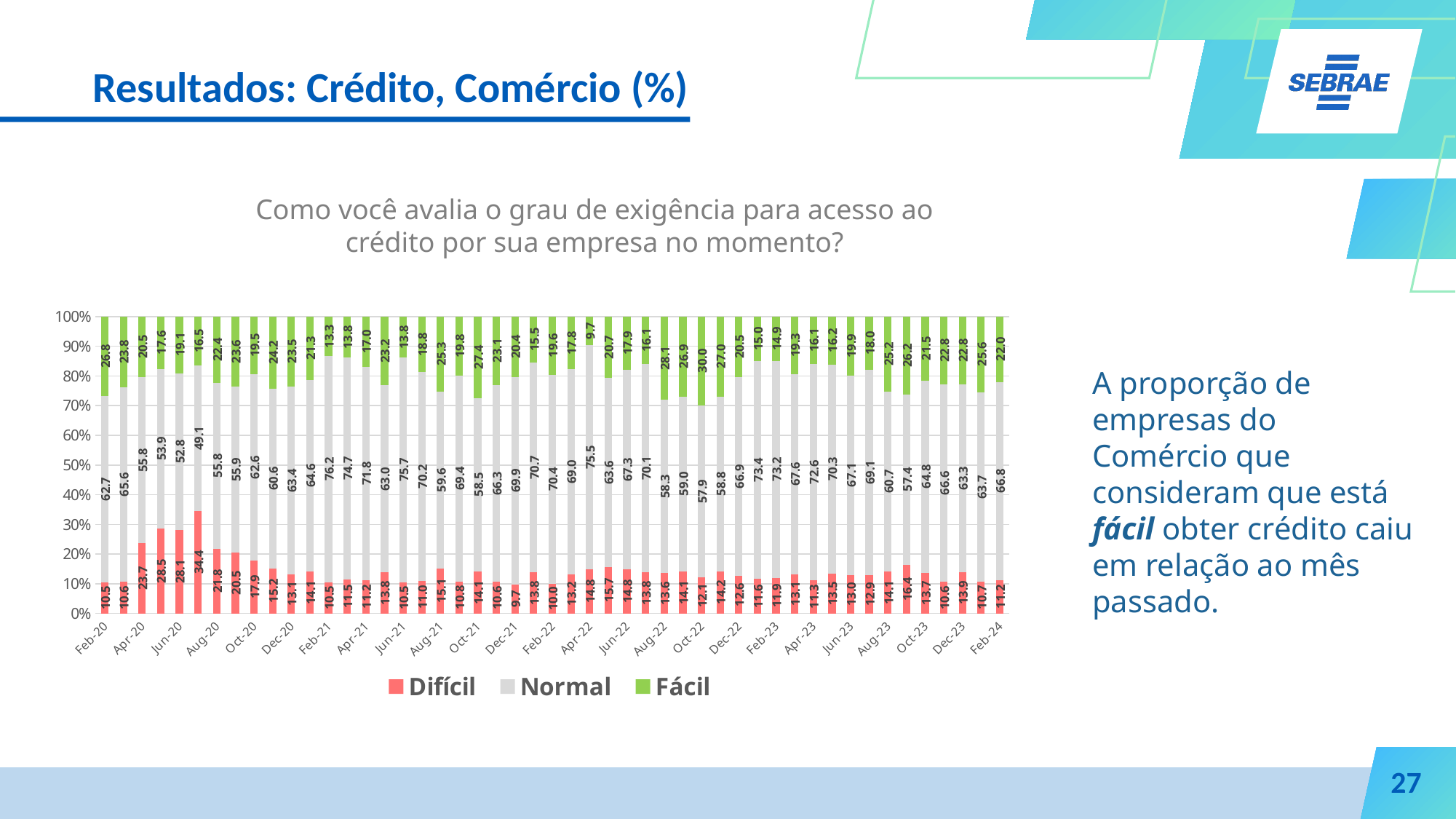
What is the Normal value for Feb-21? 76.2 In which labeled month is the Fácil value highest? Oct-22 What are the three series named in the legend? Difícil, Normal, Fácil How many series does the chart legend list? 3 What kind of chart is shown on the slide? Stacked bar chart Which month has the larger Normal value, Feb-23 or Aug-23? Feb-23 In which labeled month is the Fácil value lowest? Apr-22 What is the difference between the Difícil values for Jun-20 and Feb-20? 17.6 What is the Difícil value for Oct-22? 12.1 What is the Fácil value for Aug-22? 28.1 What is the Fácil value for Feb-24? 22.0 What is the difference between the Fácil values for Dec-23 and Feb-24? 0.8